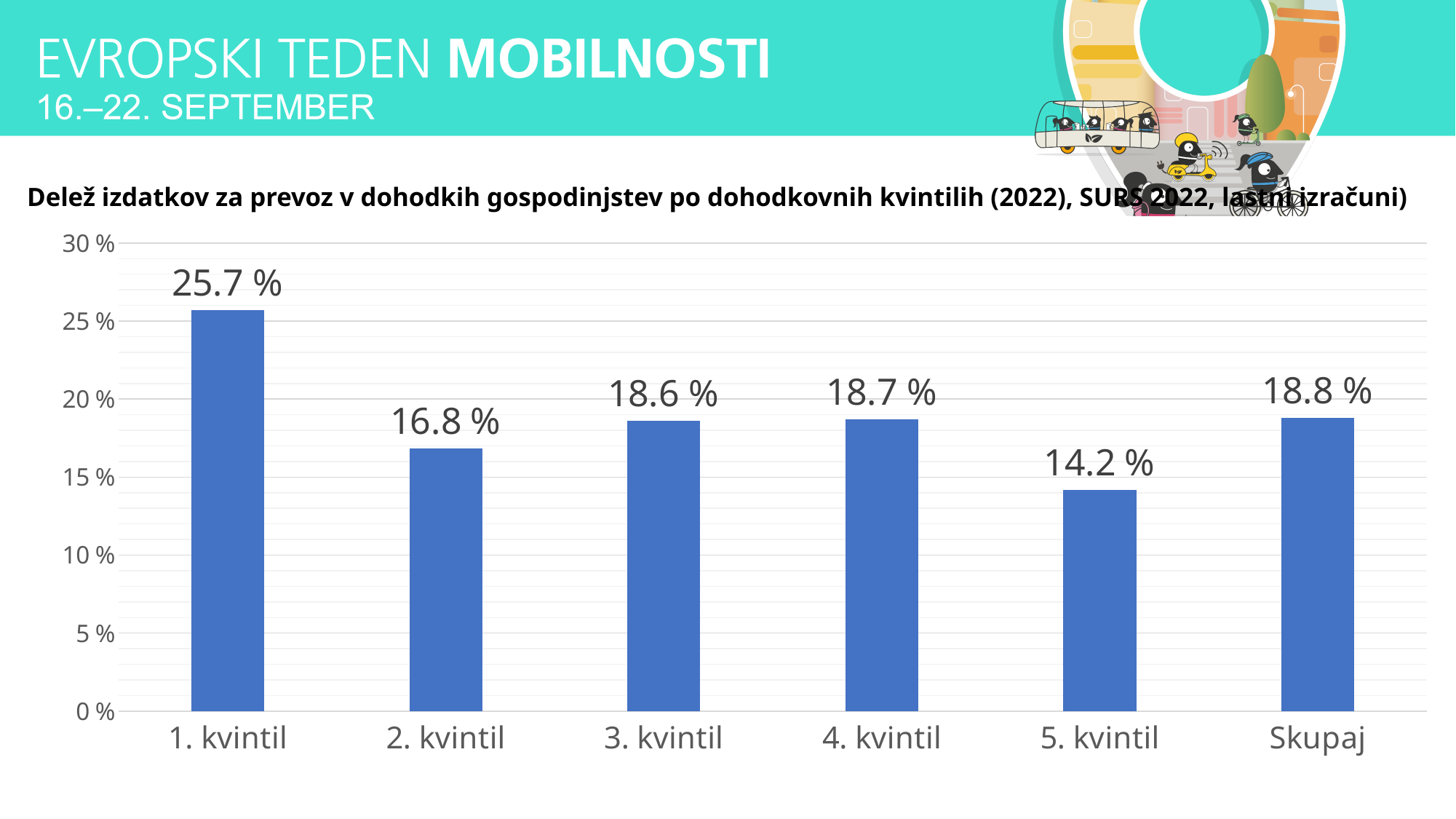
Which category has the lowest value? 5. kvintil Which category has the highest value? 1. kvintil What is the value for Skupaj? 18.8 % What is the difference between the values for 1. kvintil and 5. kvintil? 11.5 % What is the value for 1. kvintil? 25.7 % How many categories are shown on the x axis? 6 What is the highest value shown on the vertical axis? 30 % What is the value for 5. kvintil? 14.2 % What kind of chart is shown on the slide? bar chart Is the value for 4. kvintil greater or less than 20 %? less What is the difference between the values for Skupaj and 2. kvintil? 2.0 % Which is larger, the value for 2. kvintil or the value for 3. kvintil? 3. kvintil